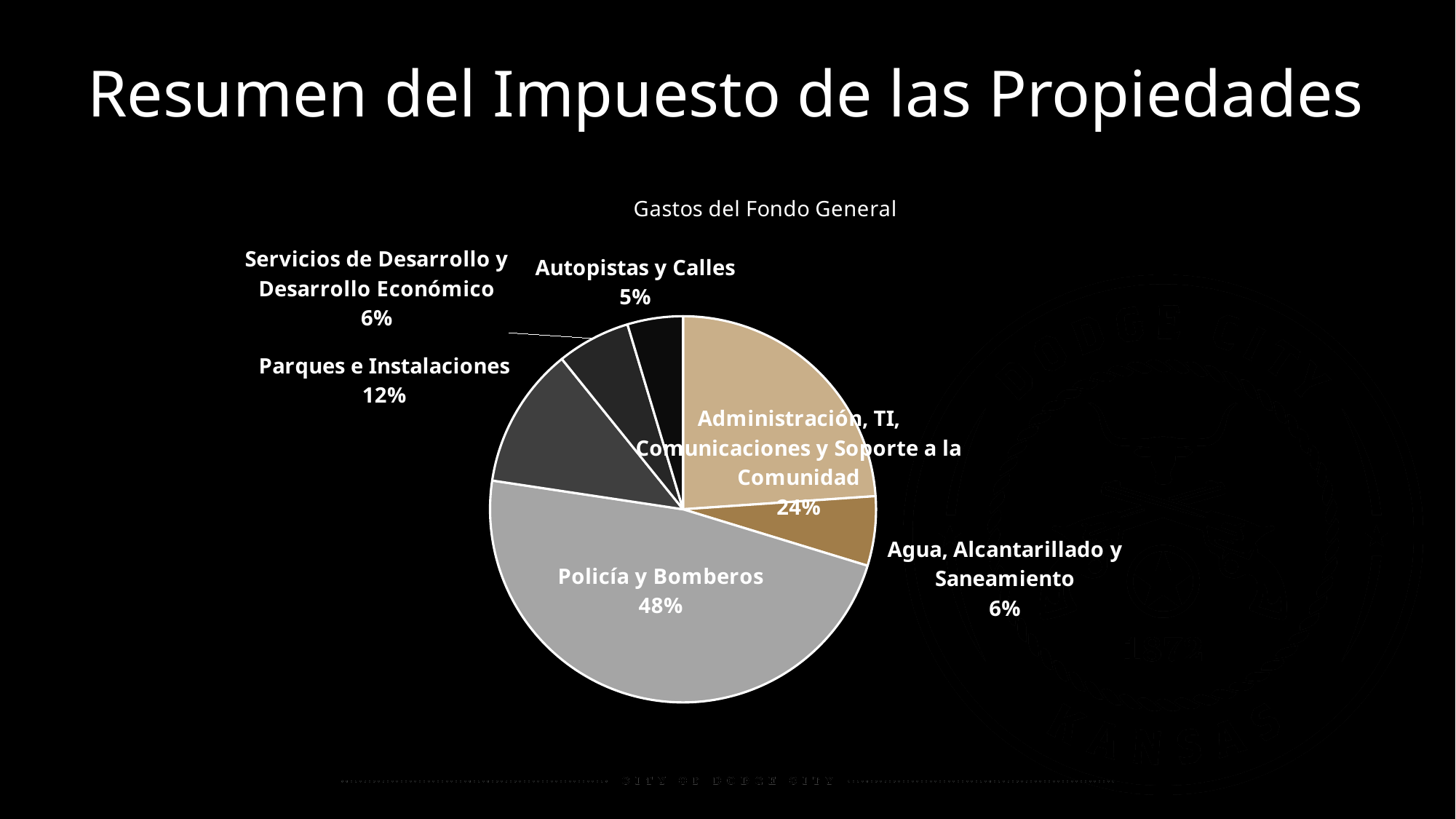
What percentage is shown for Parques e Instalaciones? 12% What is the difference in percentage points between Policía y Bomberos and Administración, TI, Comunicaciones y Soporte a la Comunidad? 24 What percentage is shown for Autopistas y Calles? 5% What percentage is shown for Administración, TI, Comunicaciones y Soporte a la Comunidad? 24% Which category has the largest share of the pie? Policía y Bomberos What type of chart is shown on the slide? Pie chart What is the title of the chart? Gastos del Fondo General Which category has the smallest share of the pie? Autopistas y Calles What share of the pie does Policía y Bomberos represent? 48% How many slices does the pie chart have? 6 What percentage is shown for Agua, Alcantarillado y Saneamiento? 6% Which is larger, Parques e Instalaciones or Servicios de Desarrollo y Desarrollo Económico? Parques e Instalaciones